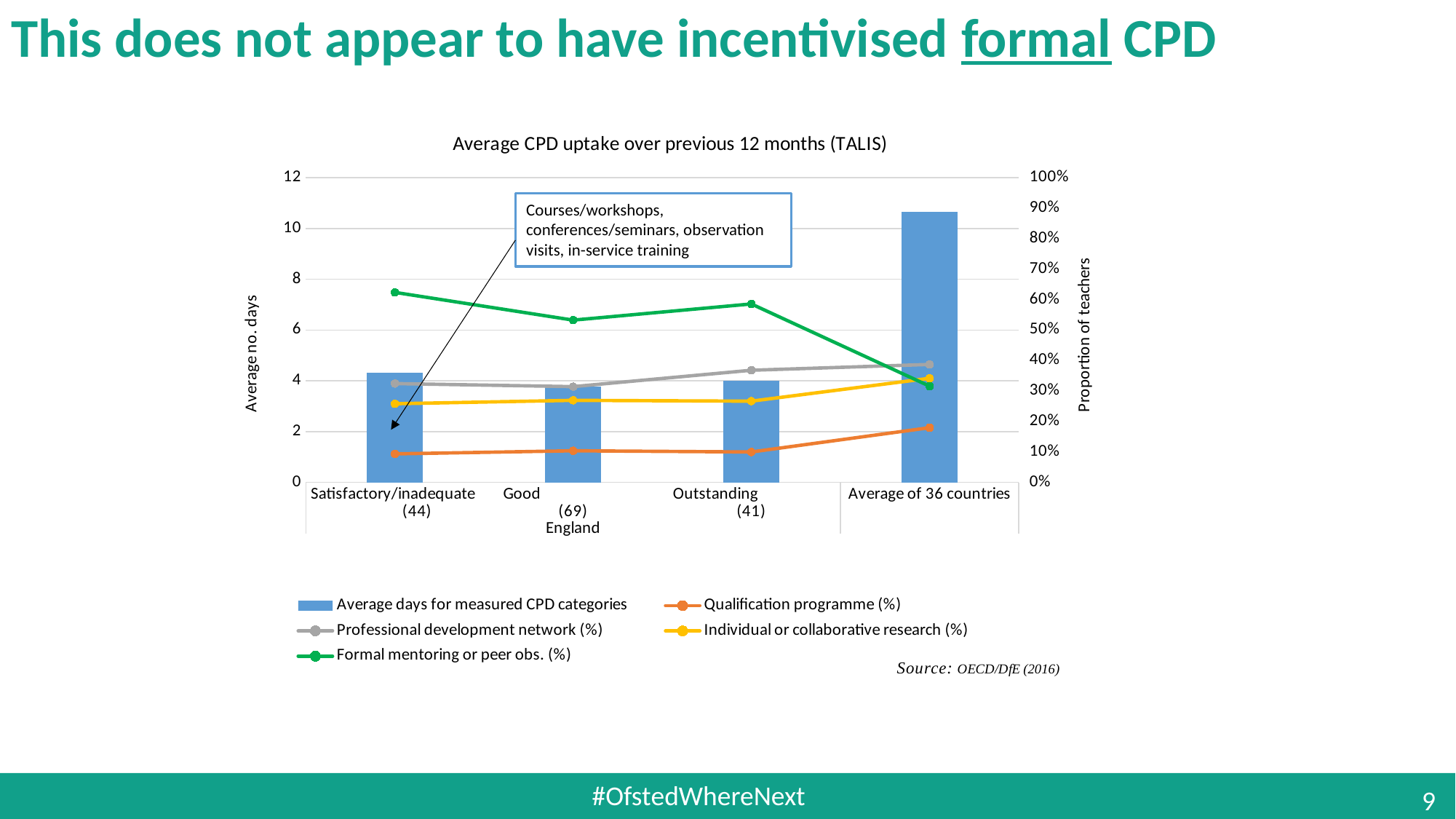
What is the title of the chart? Average CPD uptake over previous 12 months (TALIS) How many categories are shown on the x axis of the chart? 4 For Good (69), which is larger: Formal mentoring or peer obs. (%) or Qualification programme (%)? Formal mentoring or peer obs. (%) Is the Average days for measured CPD categories bar for Satisfactory/inadequate (44) greater or less than 6? less What is the label of the right-hand vertical axis? Proportion of teachers Which category has the highest value for Formal mentoring or peer obs. (%)? Satisfactory/inadequate (44) Which category has the highest value for Qualification programme (%)? Average of 36 countries Is the Average days for measured CPD categories bar for Average of 36 countries greater or less than 10? greater Is the Formal mentoring or peer obs. (%) value for Satisfactory/inadequate (44) greater or less than 50%? greater How many series does the chart legend list? 5 What kind of chart is shown on the slide? Combined bar and line chart Which category has the highest bar for Average days for measured CPD categories? Average of 36 countries